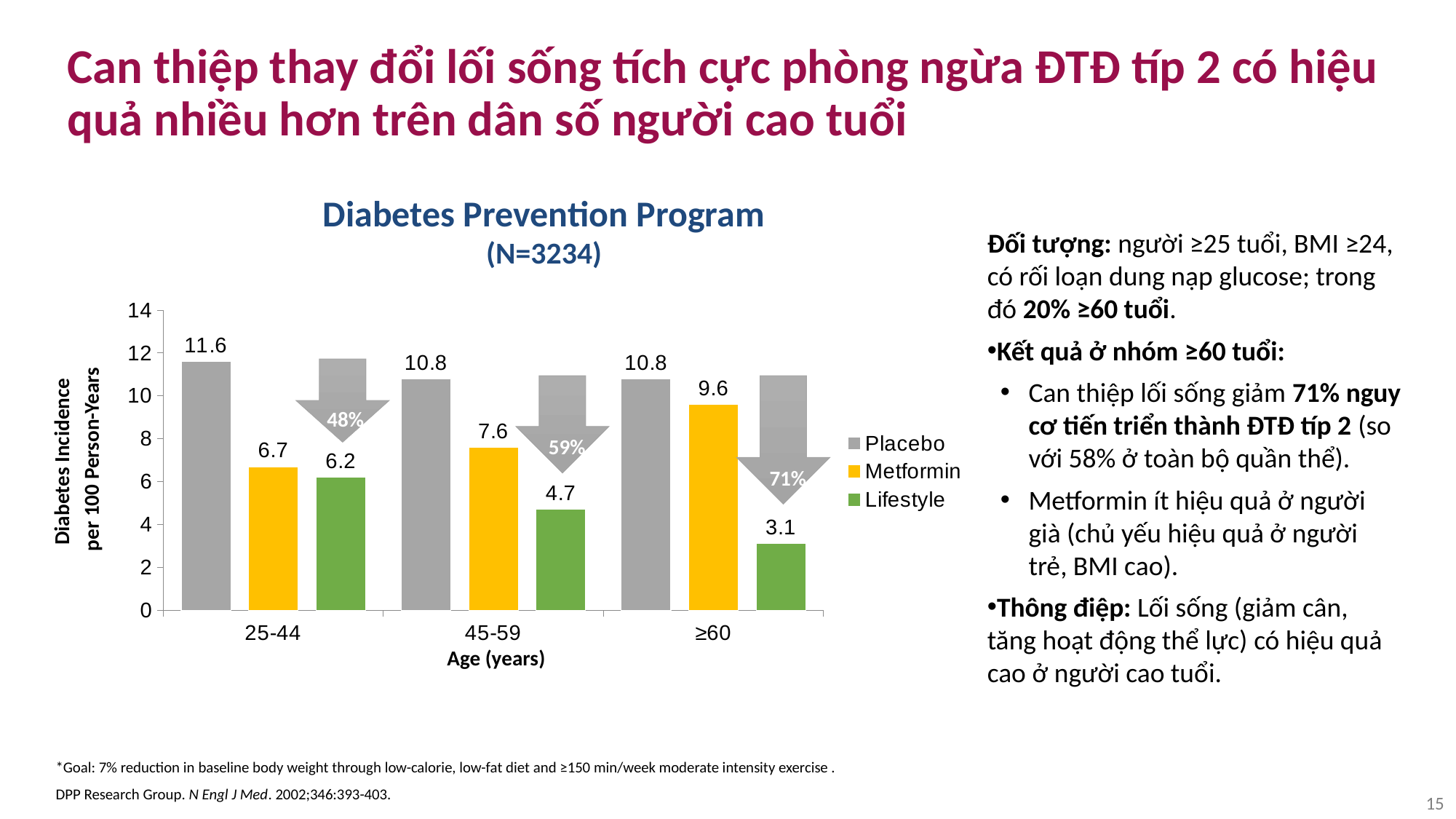
What kind of chart is shown on the slide? Bar chart How many series does the legend list? 3 Do the Lifestyle values rise or fall across the age groups from 25-44 to ≥60? Fall Which age group has the highest Placebo value? 25-44 What is the diabetes incidence for Metformin in the 45-59 age group? 7.6 Which age group has the lowest Lifestyle value? ≥60 How many age groups are shown on the x axis? 3 What is the difference between the Placebo and Lifestyle values in the ≥60 age group? 7.7 What is the diabetes incidence for Placebo in the 25-44 age group? 11.6 In the ≥60 age group, which is larger: Metformin or Lifestyle? Metformin What is the diabetes incidence for Lifestyle in the ≥60 age group? 3.1 What is the difference between the Metformin and Lifestyle values in the 45-59 age group? 2.9